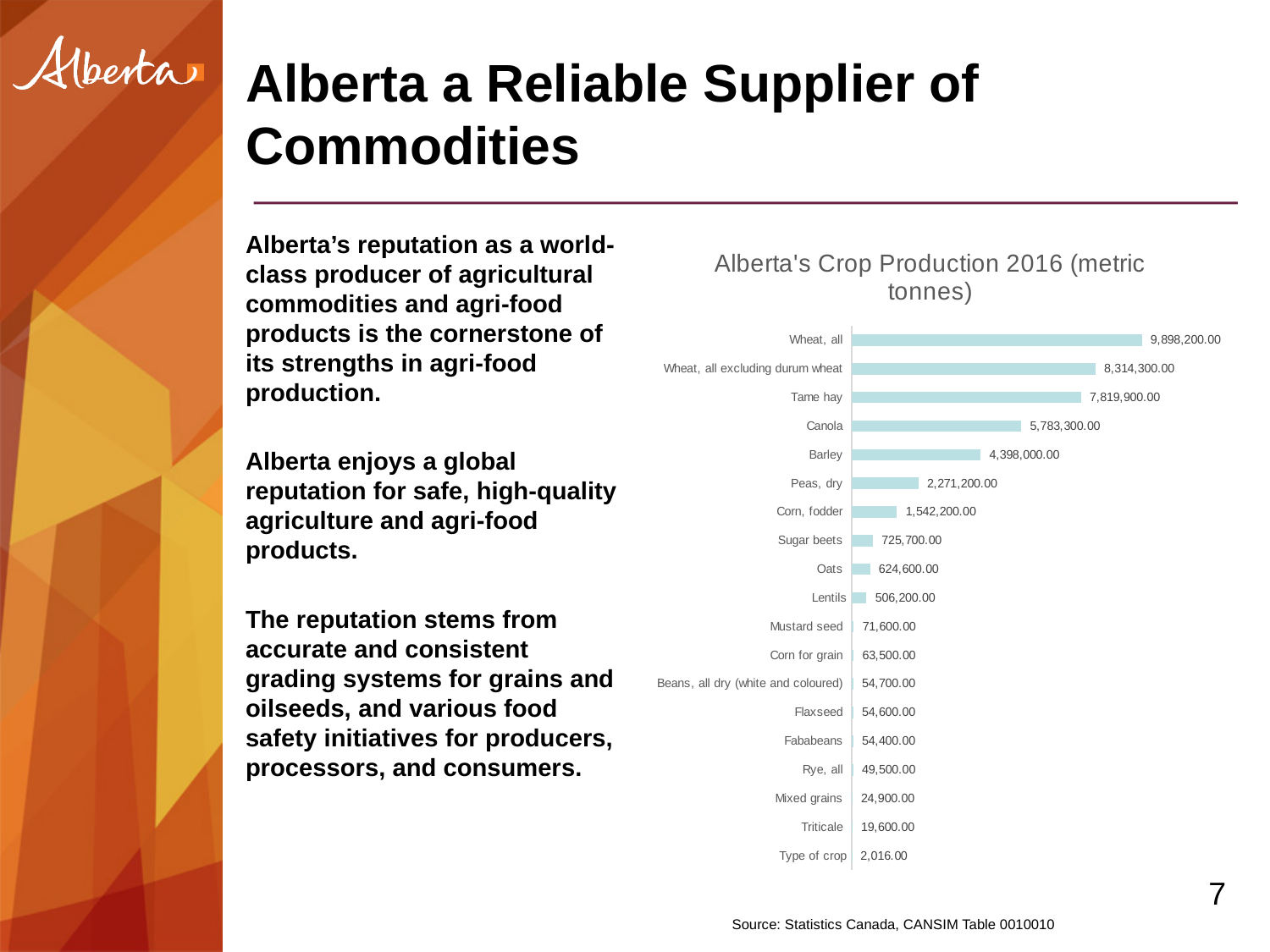
What is the crop production value for Canola in the chart? 5,783,300.00 Which has a larger production value, Sugar beets or Oats? Sugar beets What is the production value shown for Lentils? 506,200.00 What is the title of the chart? Alberta's Crop Production 2016 (metric tonnes) What is the difference between the production values for Tame hay and Canola? 2,036,600.00 Which category has the highest production value in the chart? Wheat, all What is the production value shown for Barley? 4,398,000.00 What type of chart is shown on the slide? Bar chart What is the difference between the production values for Wheat, all and Canola? 4,114,900.00 Which category has the lowest value in the chart? Type of crop What is the production value shown for Triticale? 19,600.00 How many categories are plotted in the chart? 19